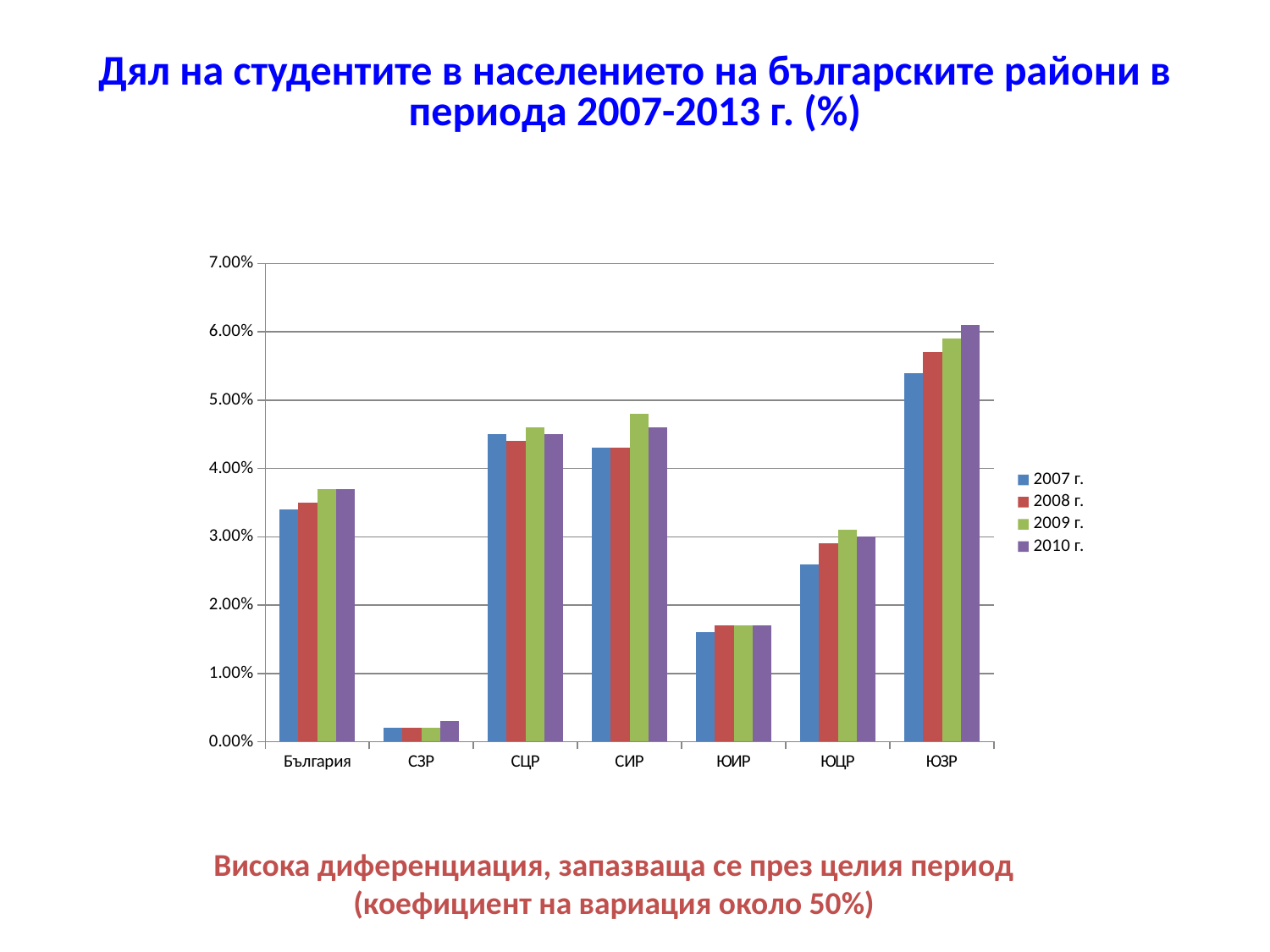
How many categories (regions) are shown on the x axis of the chart? 7 Which region has the lowest share of students in 2007 г.? СЗР Which region has the highest share of students in 2010 г.? ЮЗР Is the value for ЮЗР in 2007 г. greater or less than 5.00%? greater Is the value for СЗР in 2010 г. greater or less than 1.00%? less Which is larger in 2009 г.: the value for СИР or the value for ЮИР? СИР Is the value for ЮИР in 2007 г. greater or less than 2.00%? less Which years are listed in the legend of the chart? 2007 г., 2008 г., 2009 г., 2010 г. Do the values for ЮЗР rise or fall from 2007 г. to 2010 г.? rise What kind of chart is shown on the slide? bar chart How many series does the legend of the chart list? 4